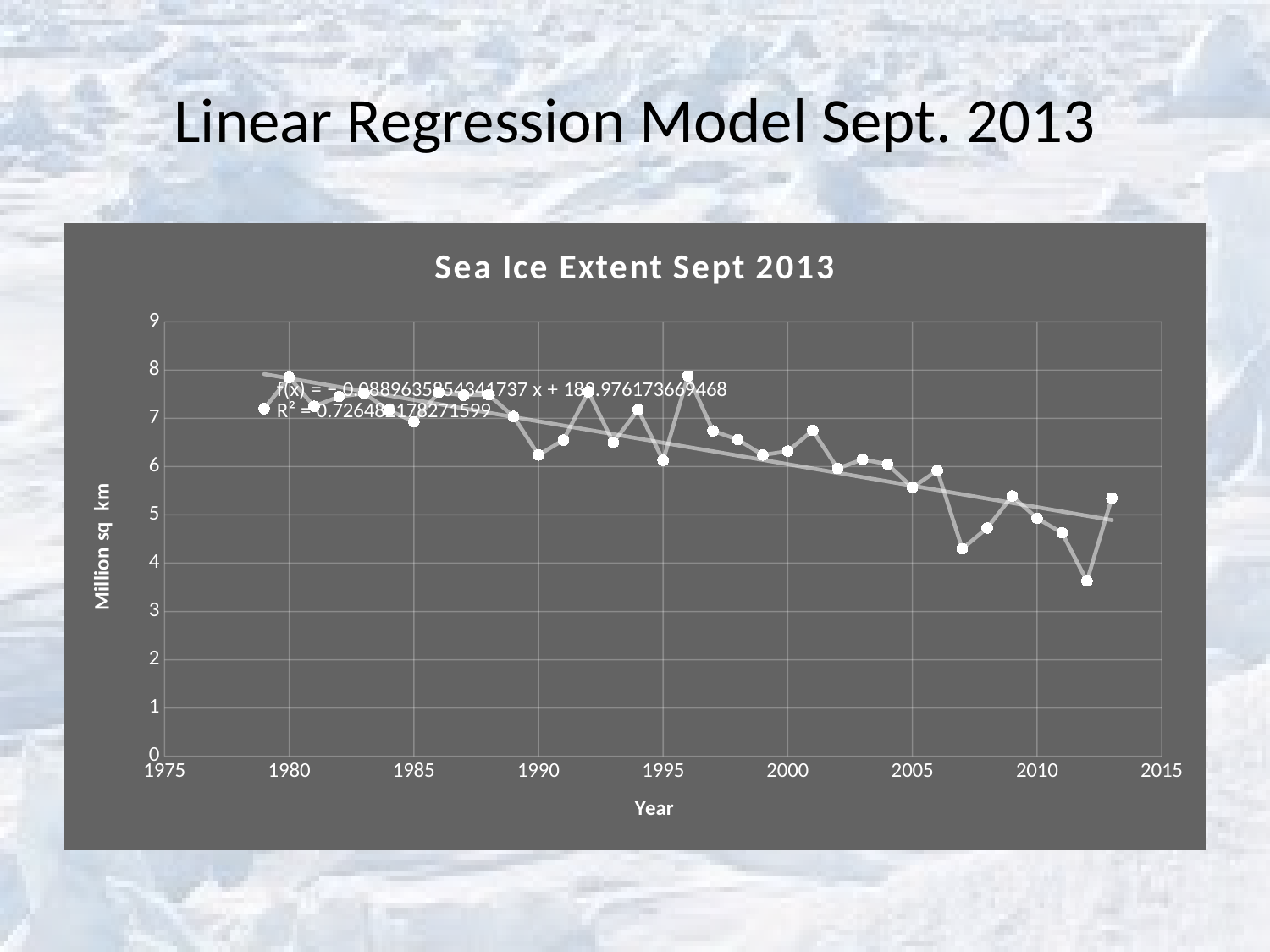
Which year has the larger sea ice extent, 2012 or 2013? 2013 Is the value for 1980 greater or less than 7? greater What is the title of the chart? Sea Ice Extent Sept 2013 Which year has the lowest sea ice extent on the chart? 2012 Which year has the larger sea ice extent, 1980 or 2007? 1980 What kind of chart is shown on the slide? line chart Which year has the larger sea ice extent, 1995 or 1996? 1996 Overall, do the sea ice extent values rise or fall from 1979 to 2013? fall What is the label on the vertical axis of the chart? Million sq km Is the value for 2012 greater or less than 4? less Is the value for 2005 greater or less than 6? less